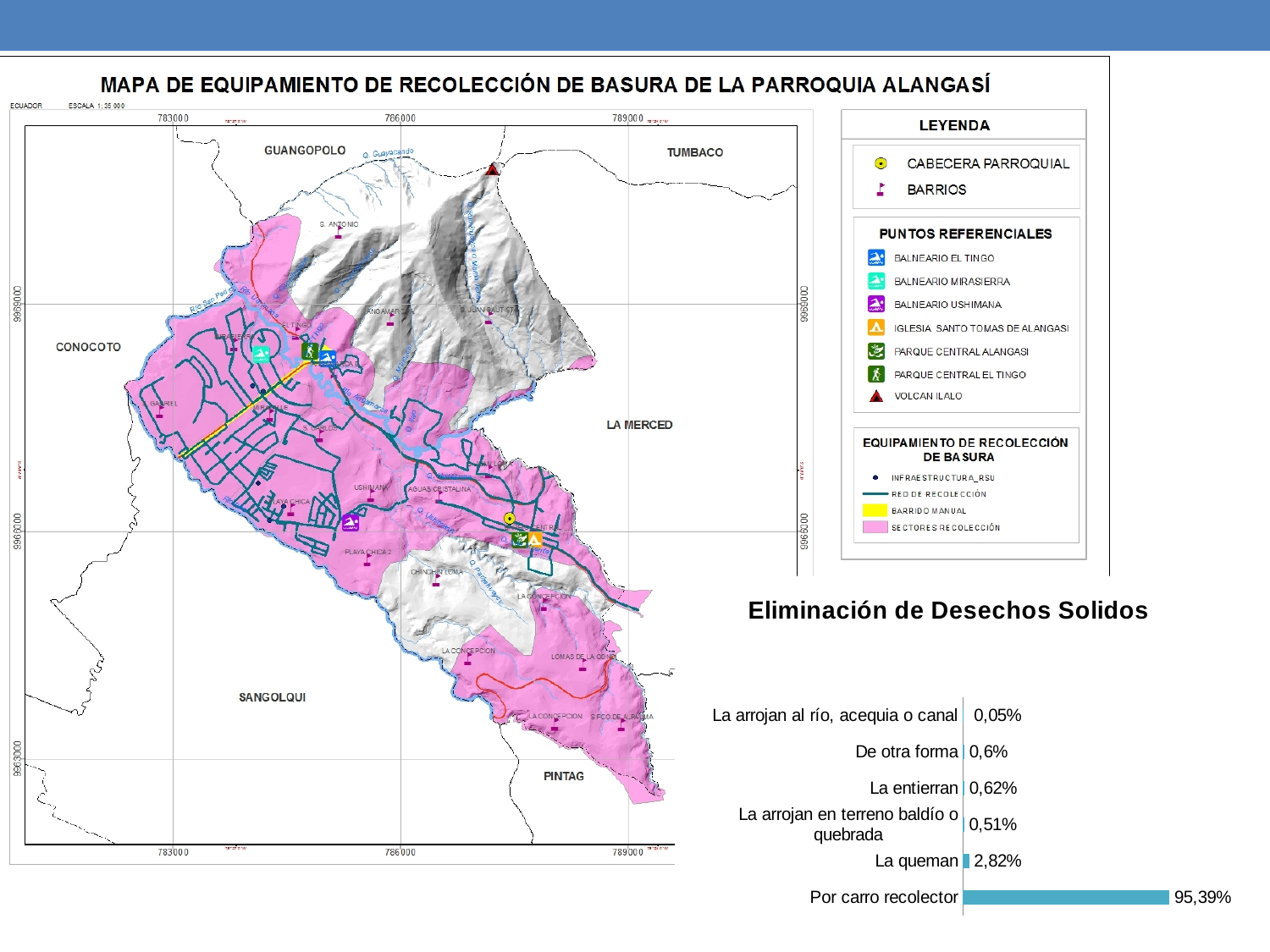
In the chart 'Eliminación de Desechos Solidos', what is the value for 'La arrojan en terreno baldío o quebrada'? 0,51% In the chart 'Eliminación de Desechos Solidos', which category has the highest value? Por carro recolector In the chart 'Eliminación de Desechos Solidos', what is the value for 'Por carro recolector'? 95,39% In the chart 'Eliminación de Desechos Solidos', what is the difference between 'Por carro recolector' and 'La queman'? 92,57% In the chart 'Eliminación de Desechos Solidos', what is the value for 'De otra forma'? 0,6% What is the title of the bar chart on the slide? Eliminación de Desechos Solidos In the chart 'Eliminación de Desechos Solidos', which is larger: 'La queman' or 'La entierran'? La queman In the chart 'Eliminación de Desechos Solidos', what is the value for 'La arrojan al río, acequia o canal'? 0,05% How many categories are shown in the chart 'Eliminación de Desechos Solidos'? 6 In the chart 'Eliminación de Desechos Solidos', what is the value for 'La entierran'? 0,62% In the chart 'Eliminación de Desechos Solidos', what is the value for 'La queman'? 2,82% In the chart 'Eliminación de Desechos Solidos', which category has the lowest value? La arrojan al río, acequia o canal